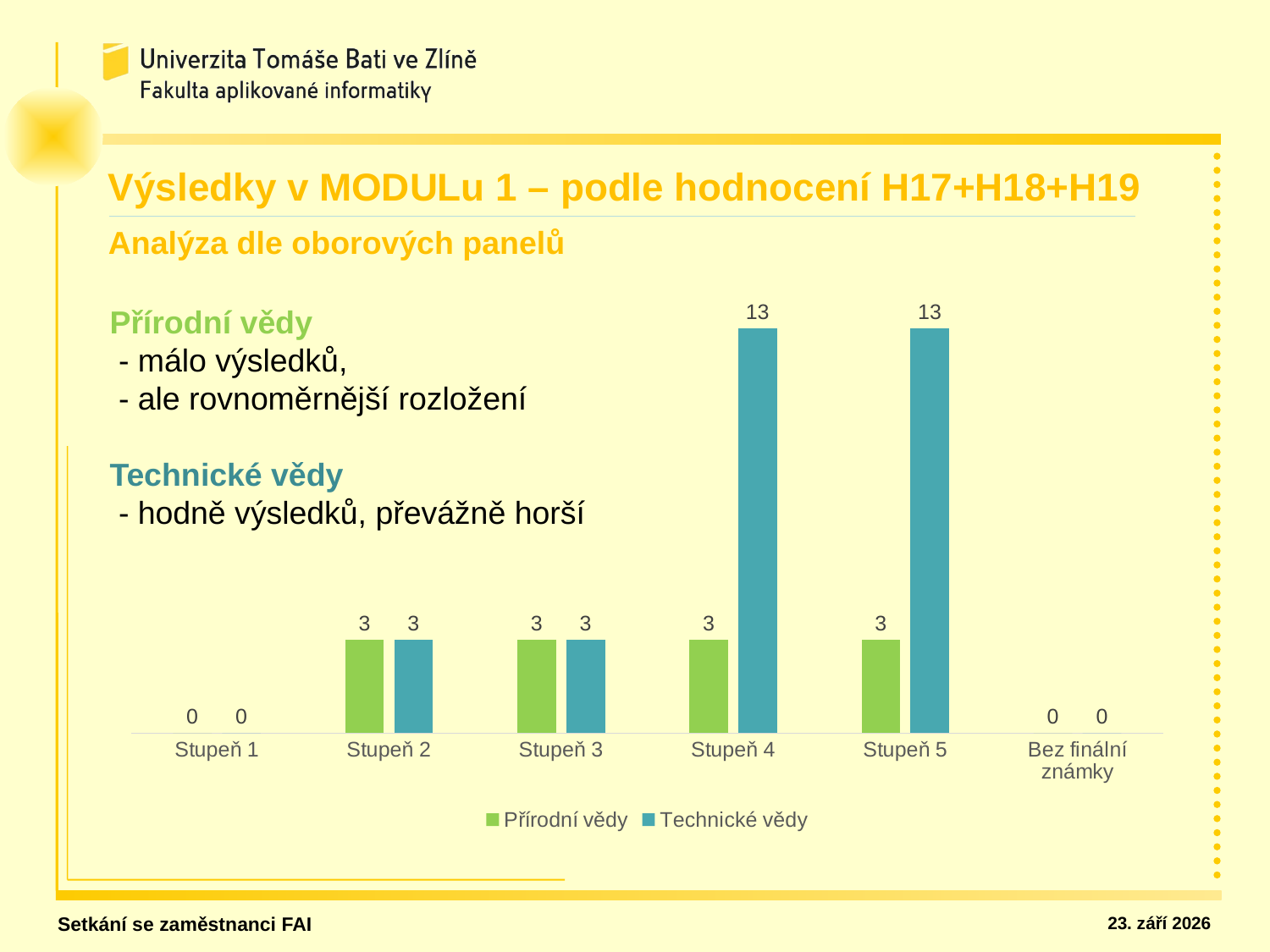
What is the value for Technické vědy at Stupeň 4? 13 What is the value for Technické vědy at Stupeň 2? 3 What is the value for Přírodní vědy at Stupeň 5? 3 Which category has the highest value for Technické vědy, Stupeň 2 or Stupeň 4? Stupeň 4 How many series does the legend list? 2 What kind of chart is shown on the slide? Bar chart What is the difference between Technické vědy and Přírodní vědy at Stupeň 5? 10 What colour represents Přírodní vědy in the legend? Green Which series has the larger value at Stupeň 4, Přírodní vědy or Technické vědy? Technické vědy What is the total of Přírodní vědy and Technické vědy at Stupeň 3? 6 What is the value for Přírodní vědy at Stupeň 1? 0 How many categories are shown on the x axis? 6